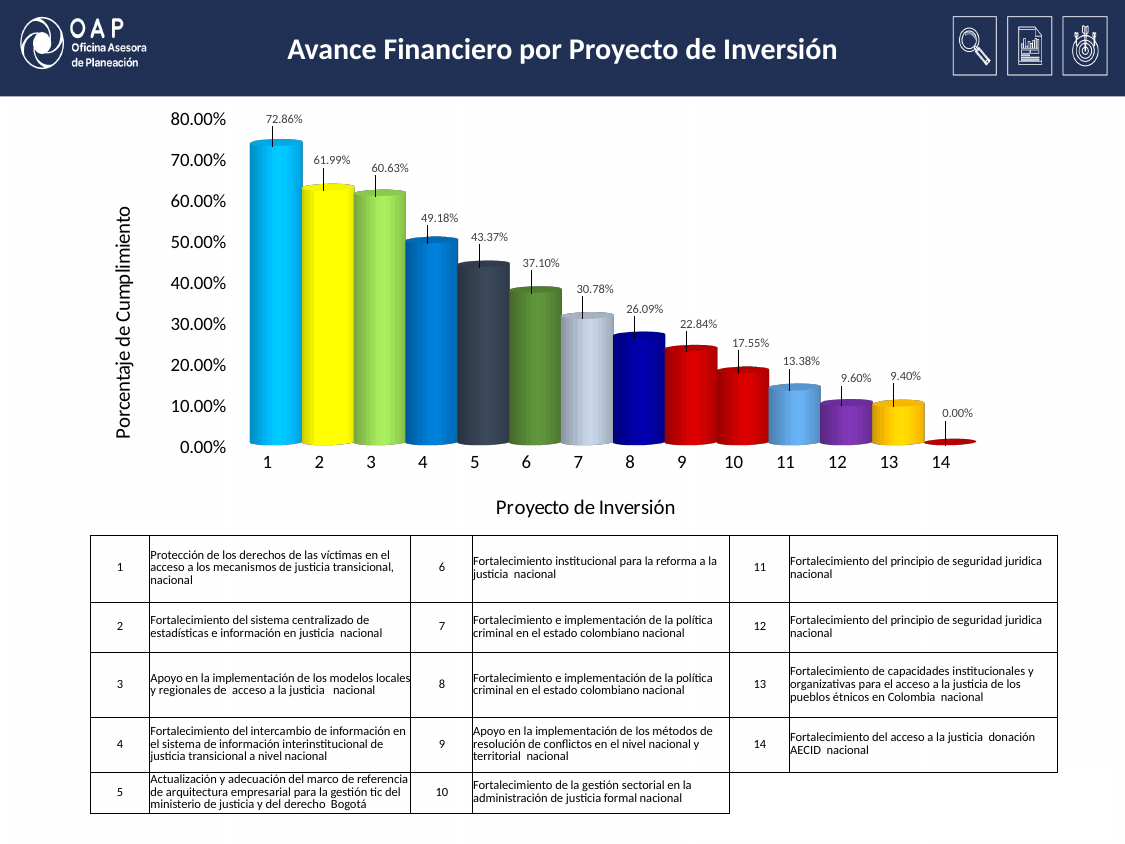
How many projects are shown on the x axis of the chart? 14 Which project has the lowest percentage of compliance? 14 What is the value for project 10 in the chart? 17.55% Which is larger, the value for project 3 or the value for project 6? project 3 Which project has the highest percentage of compliance? 1 What is the difference between the values for project 4 and project 5? 5.81% Do the values rise or fall from project 1 to project 14? fall What is the value for project 7 in the chart? 30.78% What is the difference between the values for project 1 and project 2? 10.87% What kind of chart is shown on the slide? bar chart Is the value for project 8 greater or less than 30.00%? less What is the value for project 1 in the chart? 72.86%